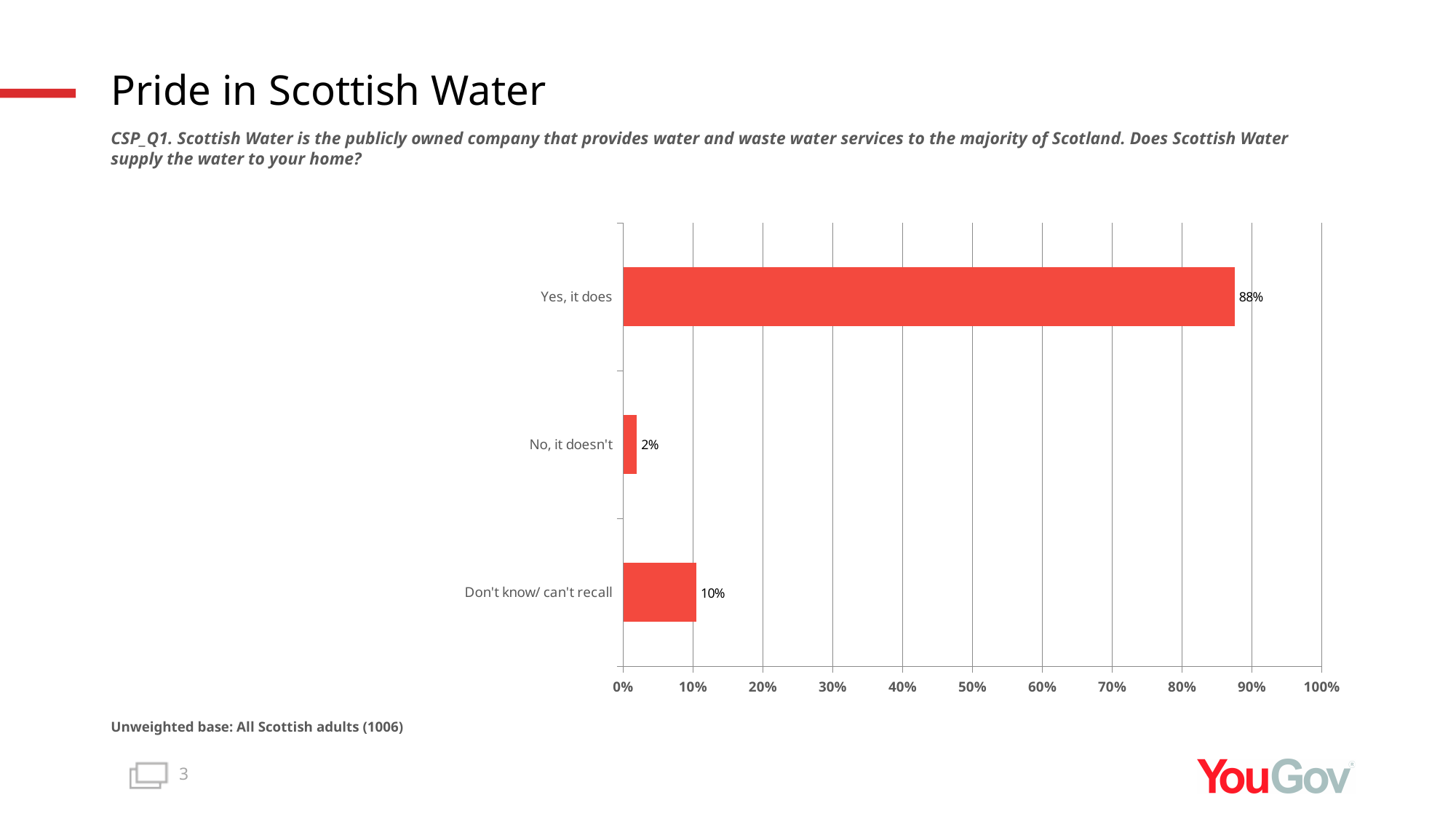
What percentage of respondents answered "Yes, it does"? 88% Which response category has the lowest value? No, it doesn't Which is larger: the value for "No, it doesn't" or the value for "Don't know/ can't recall"? Don't know/ can't recall What percentage of respondents answered "Don't know/ can't recall"? 10% What type of chart is shown on the slide? Bar chart How many response categories are shown in the chart? 3 What is the unweighted base stated below the chart? All Scottish adults (1006) Is the value for "Yes, it does" greater or less than 80%? greater Which response category has the highest value? Yes, it does What is the difference in percentage points between "Don't know/ can't recall" and "No, it doesn't"? 8 What is the difference in percentage points between "Yes, it does" and "Don't know/ can't recall"? 78 What percentage of respondents answered "No, it doesn't"? 2%